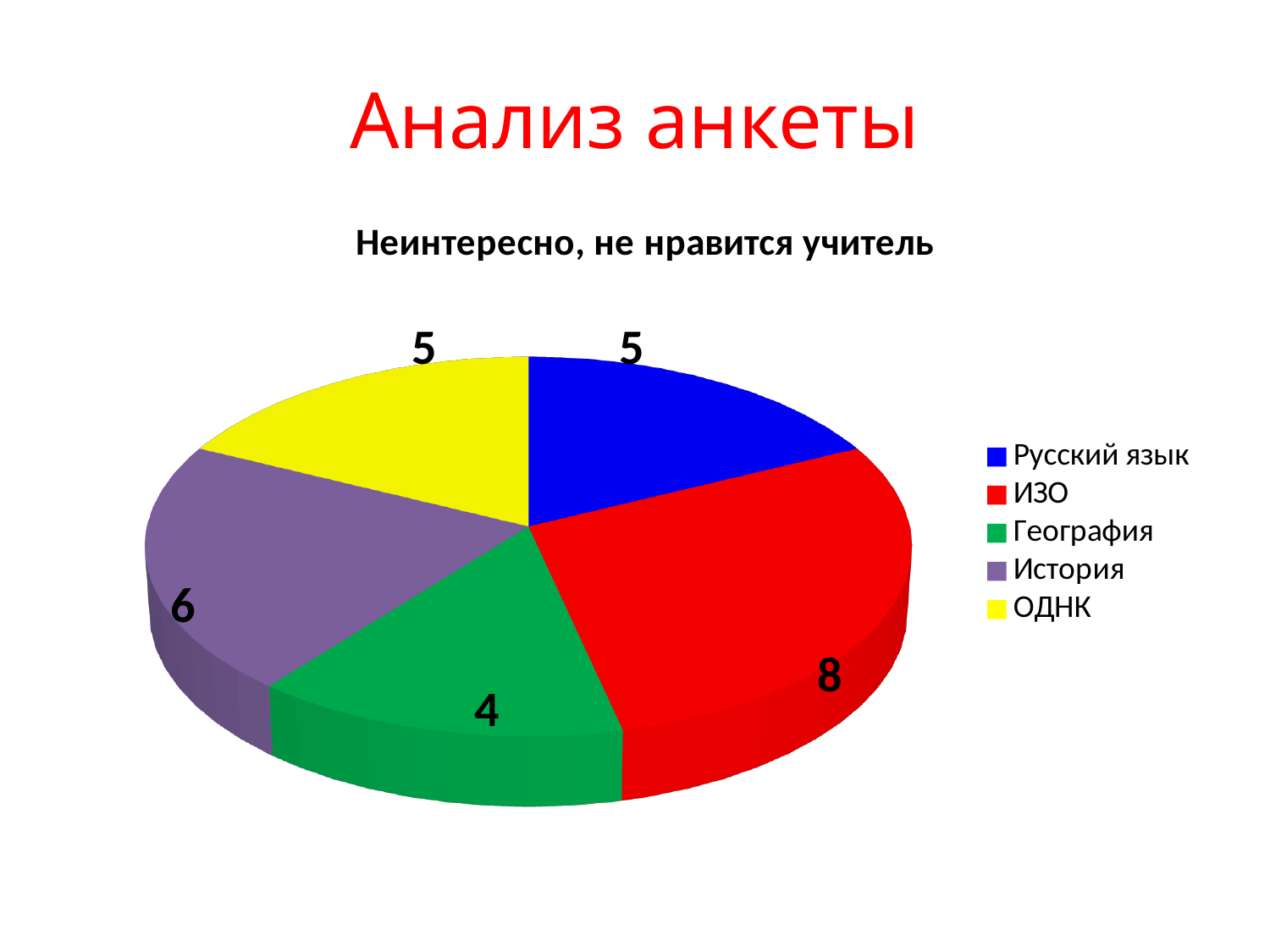
What colour is the slice for ОДНК? Yellow What is the value for История? 6 Which category has the largest slice? ИЗО What is the title of the chart? Неинтересно, не нравится учитель How many categories does the legend list? 5 What kind of chart is shown on the slide? Pie chart Which is larger, the value for История or the value for ОДНК? История What is the value for ИЗО? 8 What is the value for География? 4 Which category has the smallest slice? География What is the value for Русский язык? 5 What is the difference between the values for ИЗО and География? 4